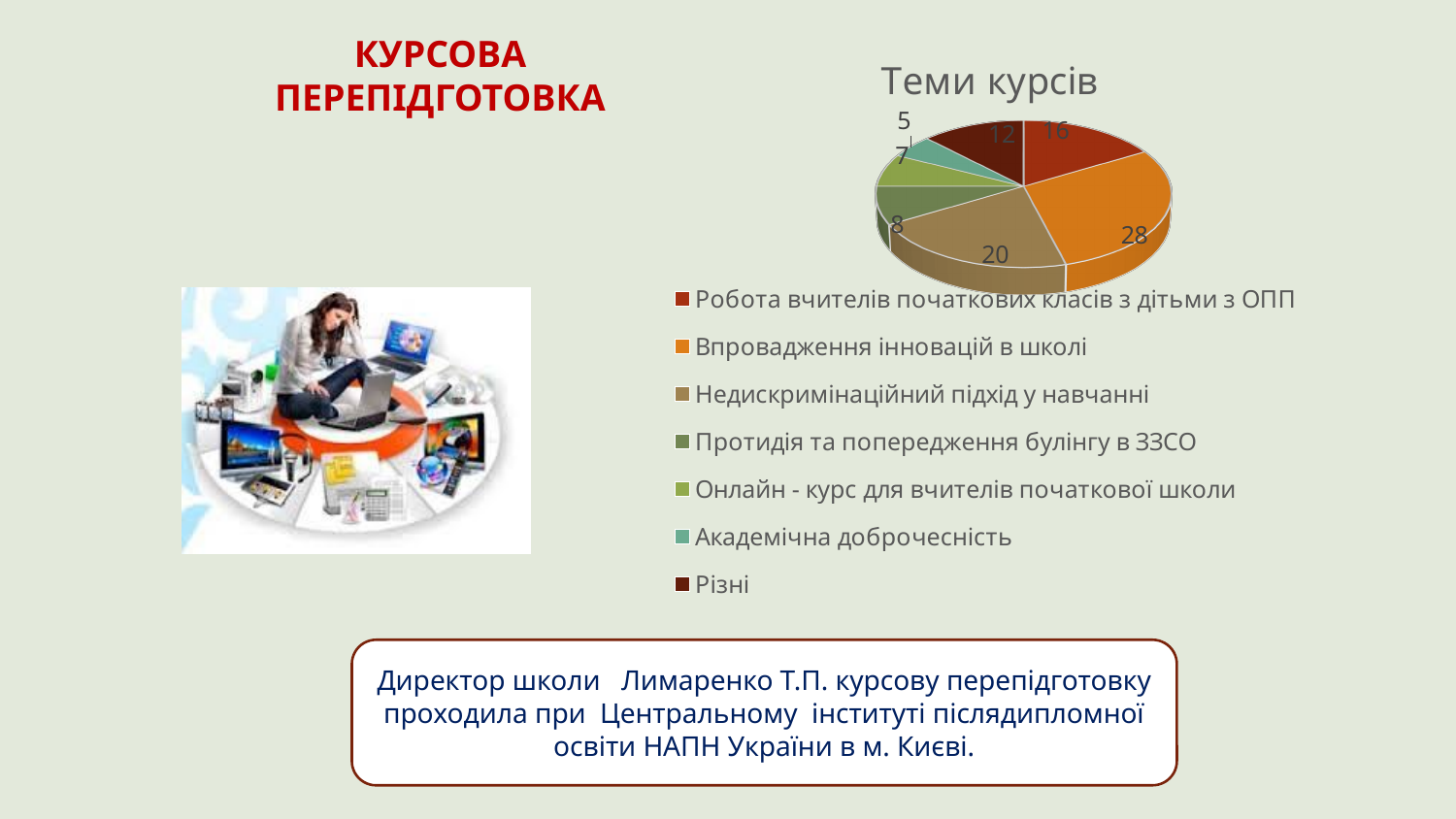
What is the value for "Недискримінаційний підхід у навчанні" in the pie chart? 20 What is the value for "Академічна доброчесність" in the pie chart? 5 What is the title of the pie chart? Теми курсів What is the difference between the values for "Впровадження інновацій в школі" and "Недискримінаційний підхід у навчанні"? 8 What kind of chart is shown under the title "Теми курсів"? Pie chart How many entries does the legend of the pie chart list? 7 What is the value for "Впровадження інновацій в школі" in the pie chart? 28 Which category has the largest slice in the pie chart? Впровадження інновацій в школі Which category has the smallest slice in the pie chart? Академічна доброчесність Which is larger in the pie chart: "Протидія та попередження булінгу в ЗЗСО" or "Онлайн - курс для вчителів початкової школи"? Протидія та попередження булінгу в ЗЗСО How many slices does the pie chart have? 7 What is the value for "Робота вчителів початкових класів з дітьми з ОПП" in the pie chart? 16